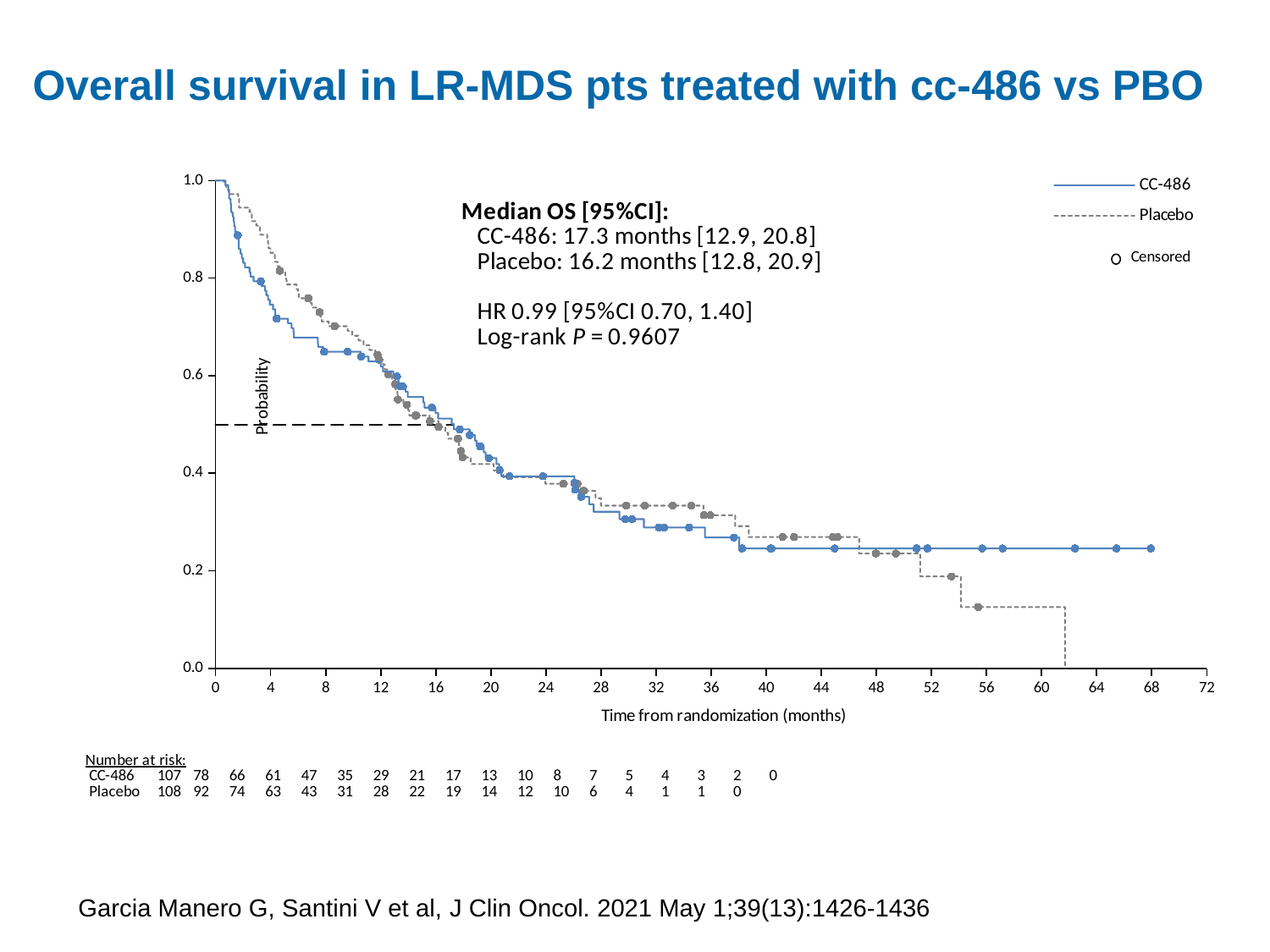
Which group has the longer median overall survival, CC-486 or Placebo? CC-486 What is the log-rank P value printed on the chart? 0.9607 What is the median overall survival for CC-486 according to the annotation on the chart? 17.3 months What is the difference in median overall survival between CC-486 and Placebo? 1.1 months What is the median overall survival for Placebo according to the annotation on the chart? 16.2 months Is the survival probability for the Placebo curve at 56 months greater or less than 0.2? less What type of chart is shown on the slide? Line chart (Kaplan-Meier survival curve) Do the survival probability curves rise or fall as time from randomization increases? fall Is the survival probability for the CC-486 curve at 68 months greater or less than 0.2? greater What is the hazard ratio (HR) printed on the chart? 0.99 How many patients were at risk in the Placebo group at 24 months? 28 How many patients were at risk in the CC-486 group at time 0? 107